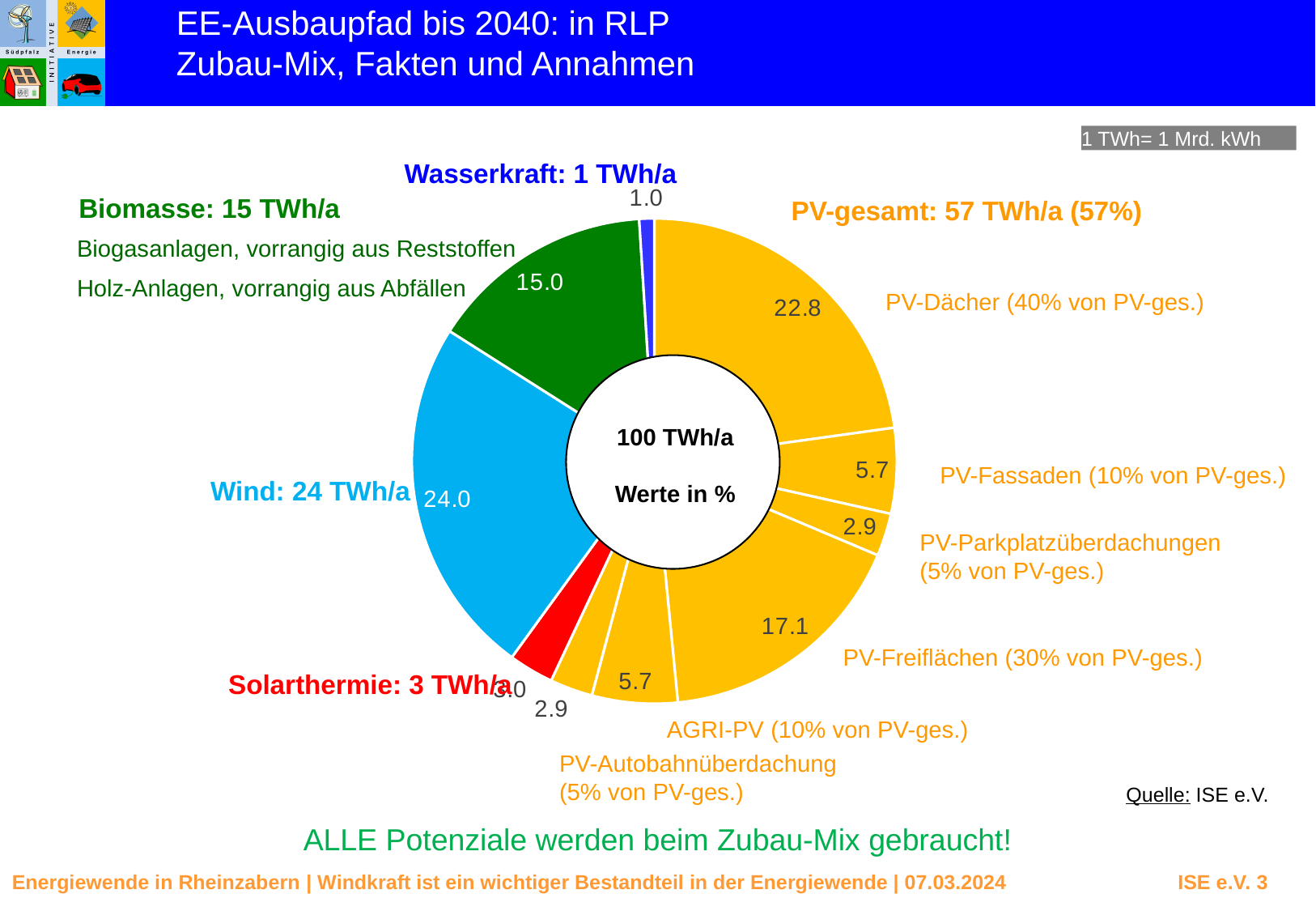
Which is larger, the PV-Dächer slice or the PV-Freiflächen slice? PV-Dächer What is the value shown for the Wasserkraft slice? 1.0 What is the difference between the Wind value and the Biomasse value? 9.0 What text is shown in the centre of the doughnut chart? 100 TWh/a, Werte in % Which slice has the smallest value? Wasserkraft What is the value shown for the Wind slice? 24.0 What is the value shown for the PV-Freiflächen slice? 17.1 What type of chart is shown on the slide? pie chart (doughnut) How many slices does the chart have? 10 What is the value shown for the PV-Dächer slice? 22.8 What is the value shown for the Biomasse slice? 15.0 Which slice has the largest value? Wind